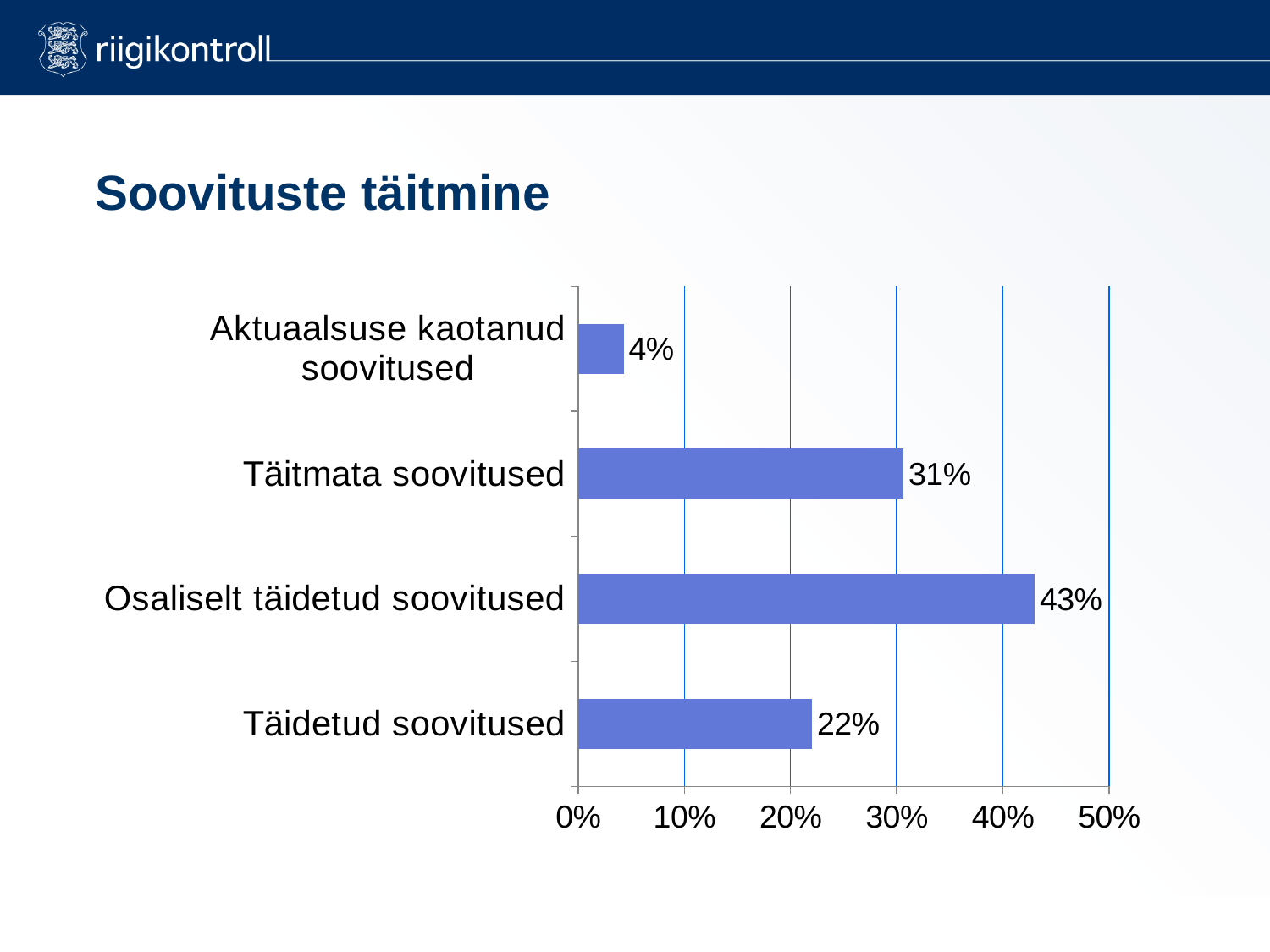
What is the value for Osaliselt täidetud soovitused? 43% Which category has the highest value? Osaliselt täidetud soovitused What is the difference between the values for Osaliselt täidetud soovitused and Täidetud soovitused? 21% What is the value for Täitmata soovitused? 31% What is the value for Täidetud soovitused? 22% Which category has the lowest value? Aktuaalsuse kaotanud soovitused Is the value for Osaliselt täidetud soovitused greater or less than 40%? greater Which is larger, the value for Täitmata soovitused or the value for Täidetud soovitused? Täitmata soovitused How many categories are shown in the chart? 4 What kind of chart is shown on the slide? bar chart What is the value for Aktuaalsuse kaotanud soovitused? 4% What is the difference between the values for Täitmata soovitused and Aktuaalsuse kaotanud soovitused? 27%